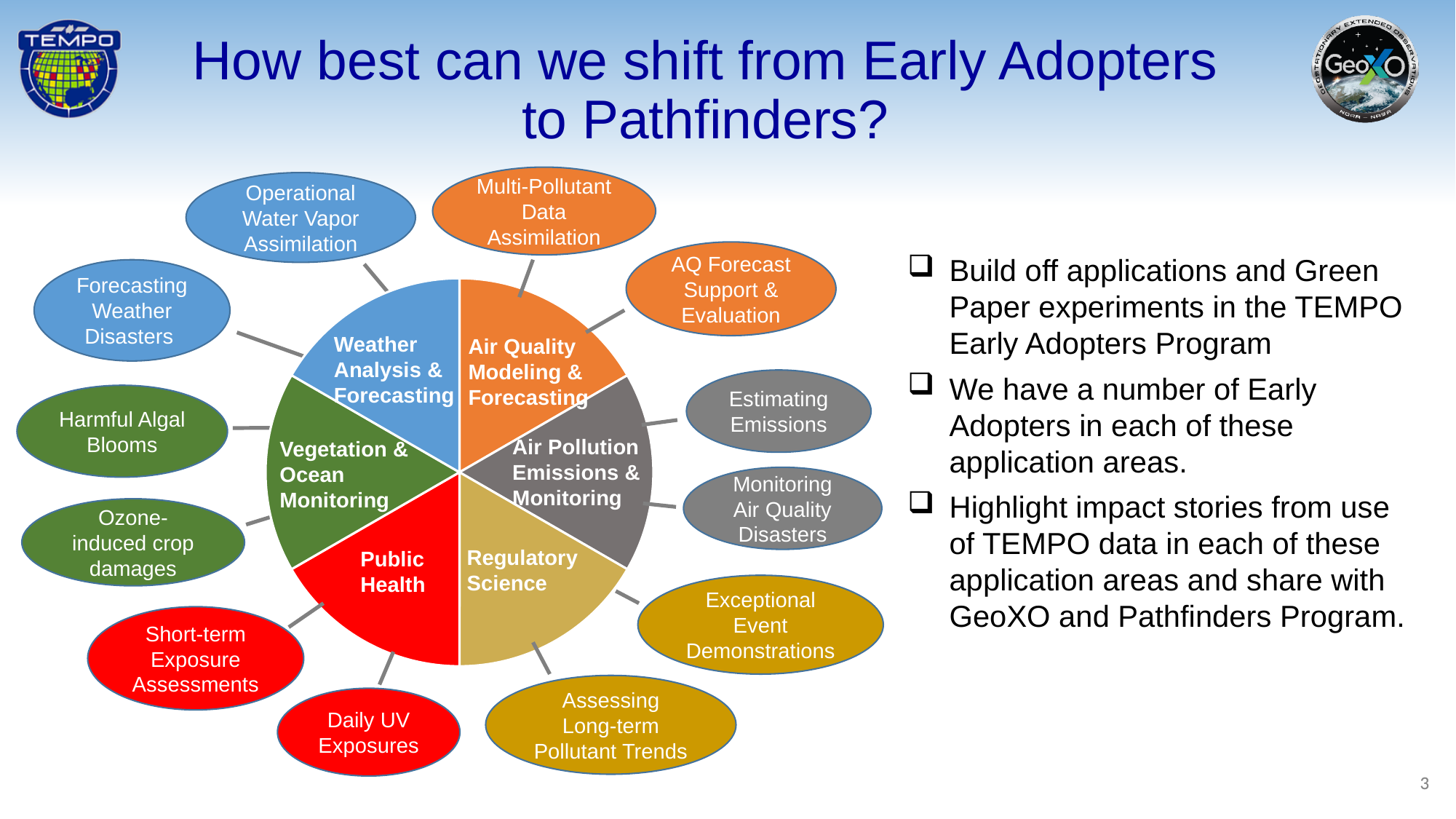
How many segments does the pie chart have? 6 Which segment of the pie chart is coloured red? Public Health Which segment is the oval 'Estimating Emissions' linked to? Air Pollution Emissions & Monitoring What kind of chart is used to show the application areas on the slide? pie chart Which segment of the pie chart is coloured green? Vegetation & Ocean Monitoring Which segment is the oval 'Harmful Algal Blooms' linked to? Vegetation & Ocean Monitoring How many ovals surround the pie chart? 12 How many ovals are connected to the Public Health segment? 2 Which segment is the oval 'AQ Forecast Support & Evaluation' linked to? Air Quality Modeling & Forecasting Which two ovals are linked to the Regulatory Science segment? Exceptional Event Demonstrations; Assessing Long-term Pollutant Trends Do the six segments of the pie chart appear equal in size? yes Which two ovals are linked to the Weather Analysis & Forecasting segment? Operational Water Vapor Assimilation; Forecasting Weather Disasters